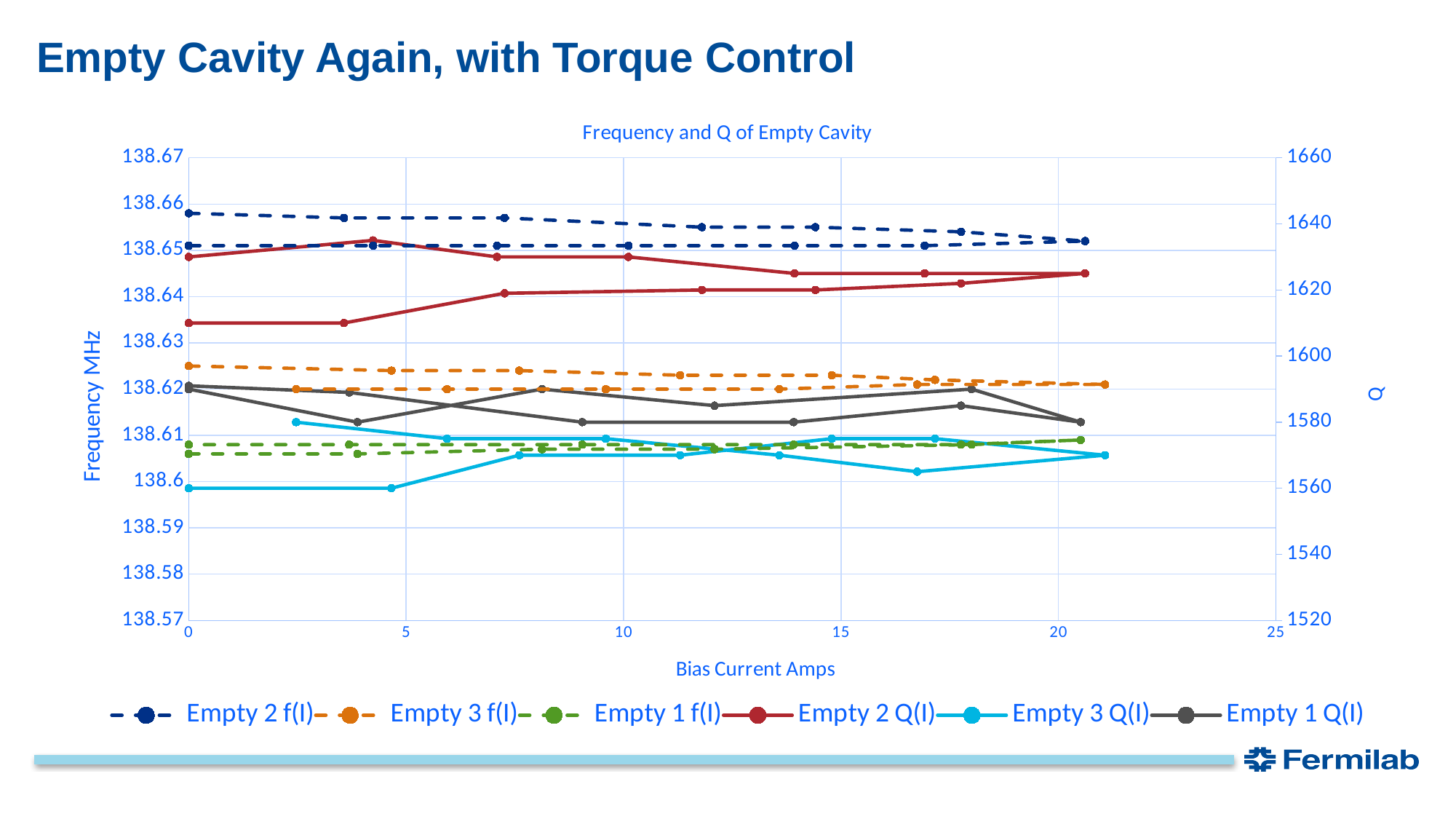
How many series does the chart legend list? 6 What kind of chart is shown on the slide? line chart Are the Empty 2 f(I) values greater or less than 138.65 MHz? greater Are the Empty 1 f(I) values greater or less than 138.61 MHz? less Do the Empty 2 f(I) values rise or fall as bias current increases? fall Which series has higher frequency values, Empty 2 f(I) or Empty 1 f(I)? Empty 2 f(I) Which series has higher Q values, Empty 2 Q(I) or Empty 3 Q(I)? Empty 2 Q(I) Are the Empty 2 Q(I) values greater or less than 1600? greater What is the title of the chart? Frequency and Q of Empty Cavity What is the label of the x axis of the chart? Bias Current Amps